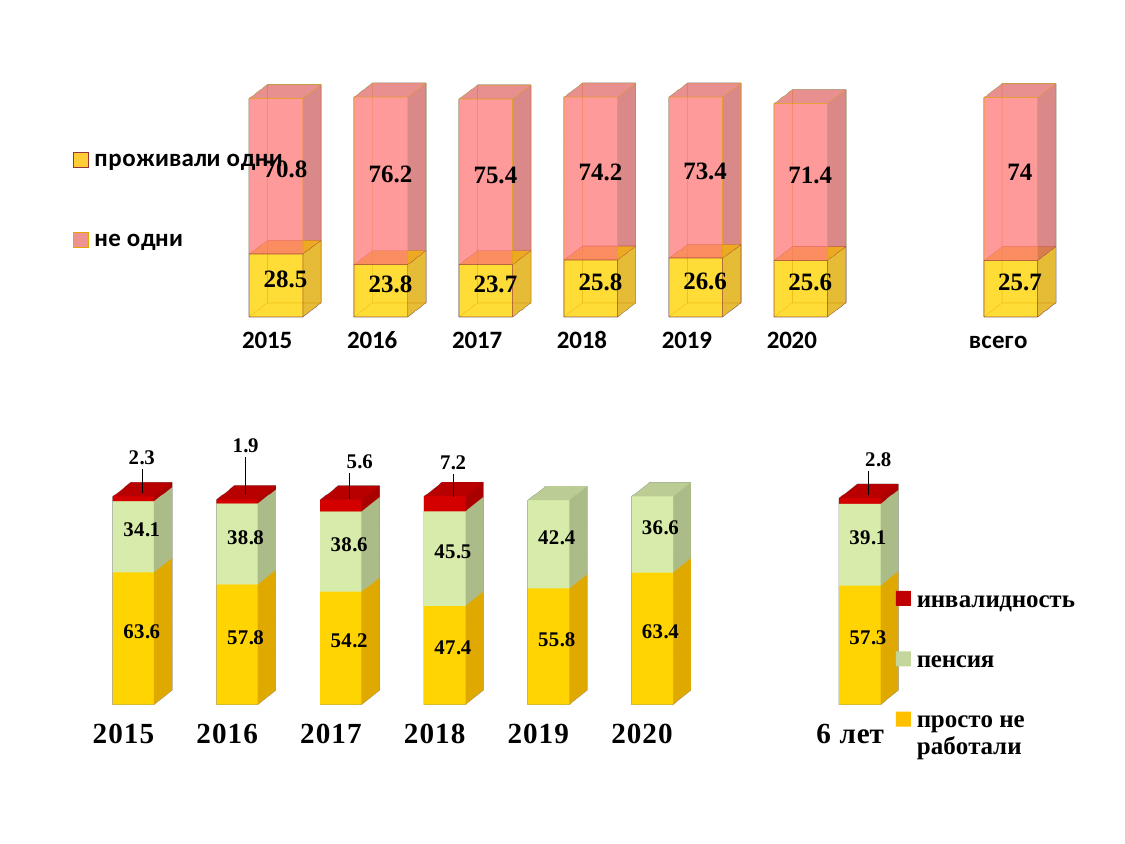
In the top chart, which year has the highest value for "проживали одни"? 2015 In the top chart, what is the difference between the "не одни" values for 2016 and 2020? 4.8 In the top chart, what is the value for "не одни" in 2016? 76.2 In the bottom chart, what is the value for "пенсия" in 2018? 45.5 In the bottom chart, what is the value for "инвалидность" in 2017? 5.6 In the bottom chart, is the "просто не работали" value larger in 2015 or in 2020? 2015 In the top chart, what is the value for "проживали одни" in 2015? 28.5 In the top chart, how many series does the legend list? 2 What kind of chart is the bottom chart? stacked bar chart In the top chart, what is the value for "не одни" in the "всего" bar? 74 In the top chart, which year has the lowest value for "не одни"? 2015 In the bottom chart, which year has the lowest value for "просто не работали"? 2018